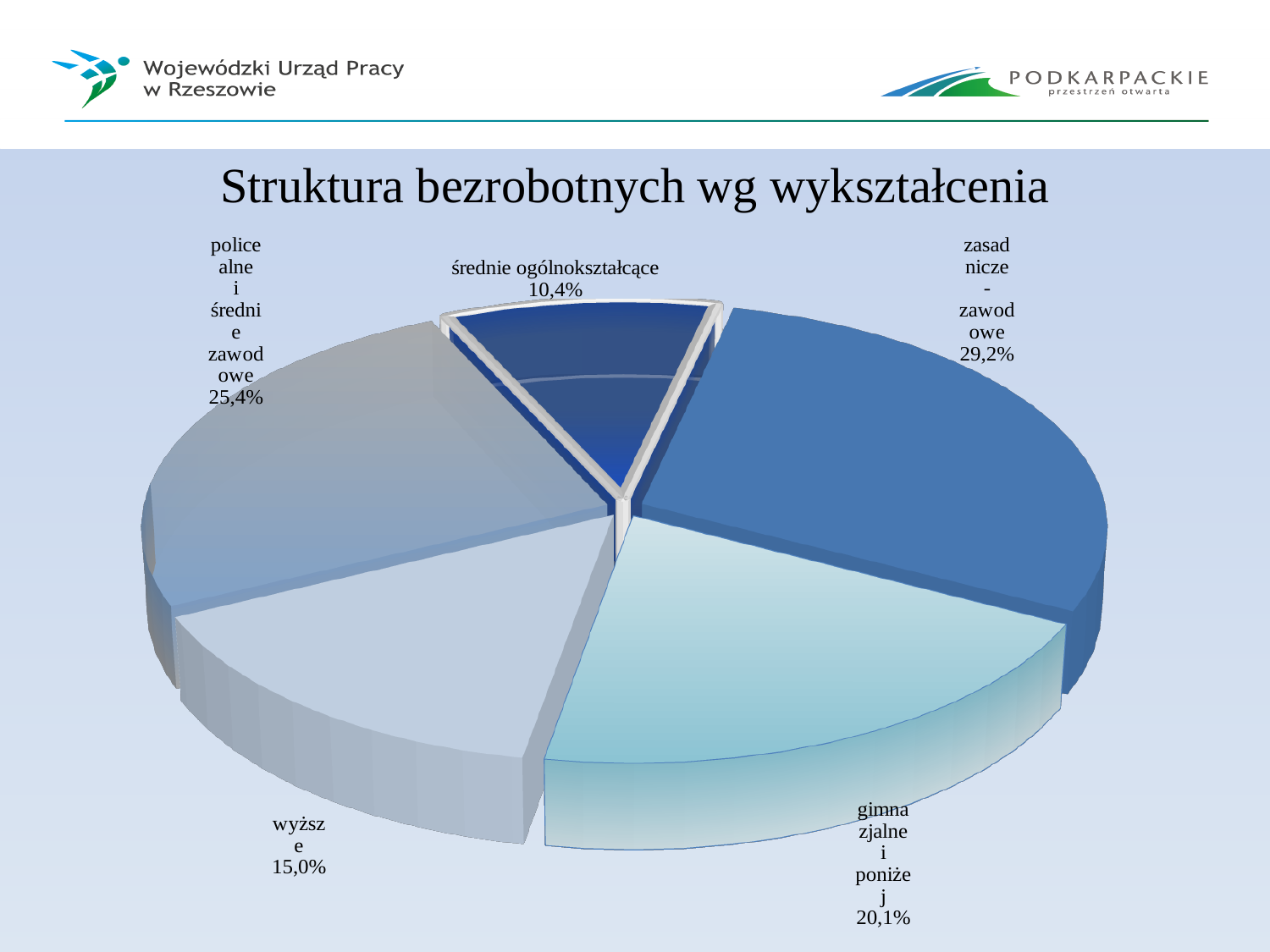
How many slices does the pie chart have? 5 What is the title of the chart? Struktura bezrobotnych wg wykształcenia What share of the pie is labelled for 'zasadnicze zawodowe'? 29,2% What share of the pie is labelled for 'średnie ogólnokształcące'? 10,4% What is the difference in percentage points between 'zasadnicze zawodowe' and 'policealne i średnie zawodowe'? 3,8 Which category has the smallest share of the pie? średnie ogólnokształcące What share of the pie is labelled for 'gimnazjalne i poniżej'? 20,1% What share of the pie is labelled for 'wyższe'? 15,0% Which is larger, the share for 'gimnazjalne i poniżej' or the share for 'wyższe'? gimnazjalne i poniżej Which category has the largest share of the pie? zasadnicze zawodowe What share of the pie is labelled for 'policealne i średnie zawodowe'? 25,4% What kind of chart is shown on the slide? pie chart